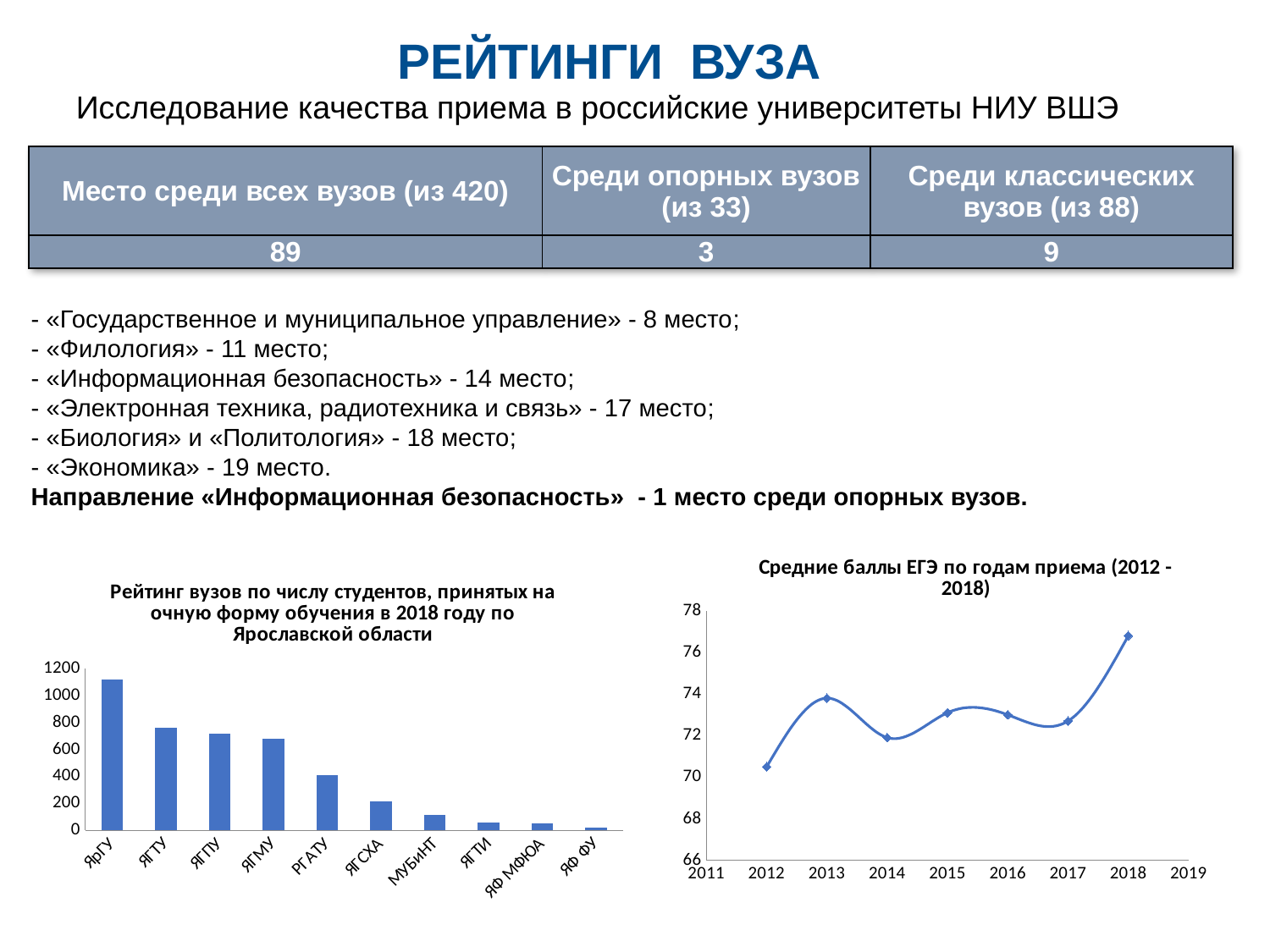
In the bar chart on the left, which university has the lowest number of admitted students? ЯФ ФУ What kind of chart is the chart titled «Рейтинг вузов по числу студентов, принятых на очную форму обучения в 2018 году по Ярославской области»? bar chart In the line chart on the right, which year has the lowest average score? 2012 In the bar chart on the left, how many universities are shown? 10 What kind of chart is the chart titled «Средние баллы ЕГЭ по годам приема (2012 - 2018)»? line chart In the line chart on the right, which year has the highest average score? 2018 In the bar chart on the left, which is larger: the value for ЯГТУ or the value for ЯГСХА? ЯГТУ In the bar chart on the left, is the value for ЯрГУ greater or less than 1000? greater In the bar chart on the left, is the value for РГАТУ greater or less than 600? less In the bar chart on the left, which university has the highest number of admitted students? ЯрГУ In the line chart on the right, how many years are plotted? 7 In the line chart on the right, is the value for 2018 greater or less than 76? greater